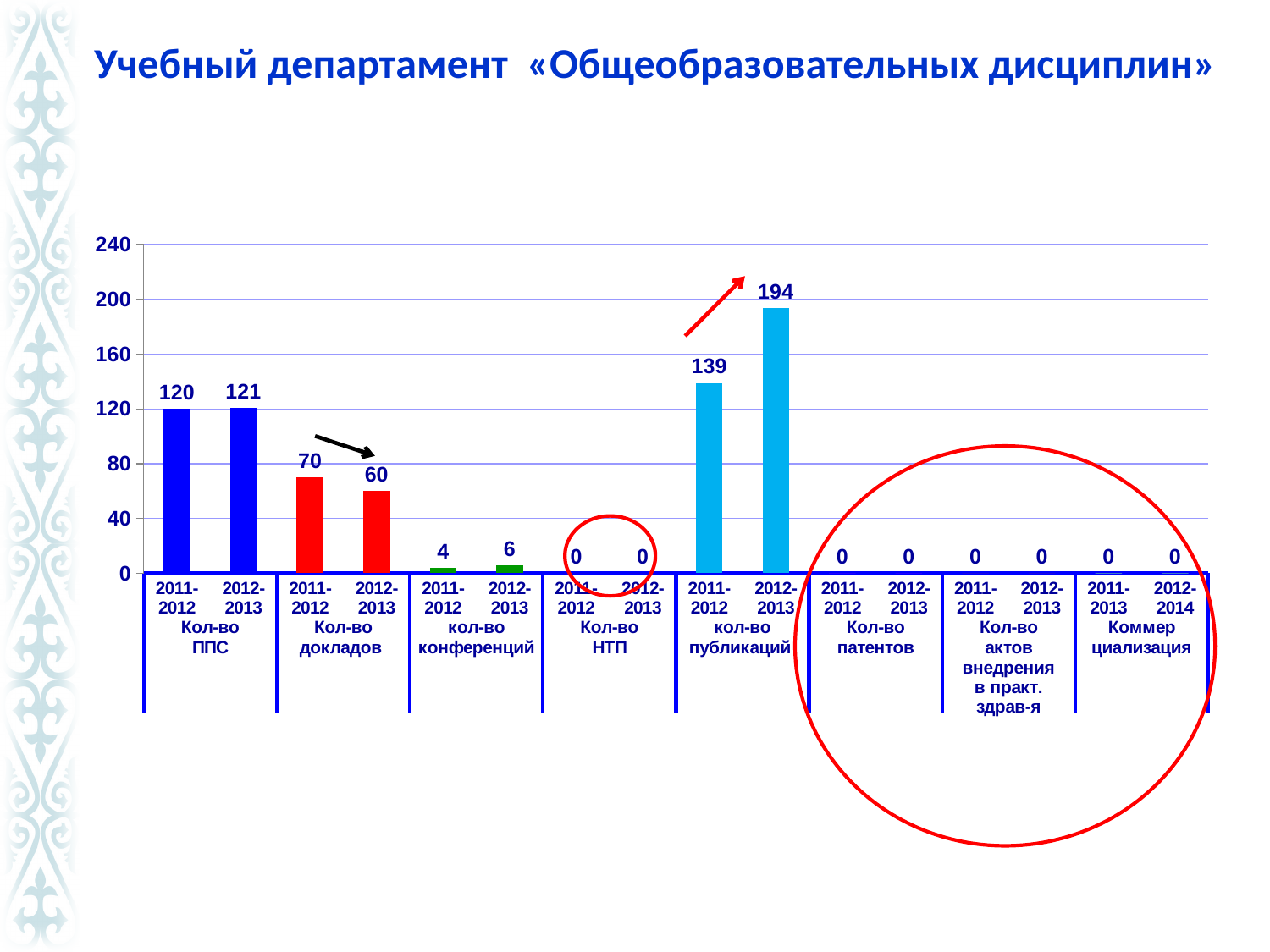
By how much did "кол-во публикаций" increase from 2011-2012 to 2012-2013? 55 What is the value for "кол-во конференций" in 2011-2012? 4 What is the difference between "Кол-во докладов" in 2011-2012 and 2012-2013? 10 What is the value for "Кол-во ППС" in 2011-2012? 120 Which bar has the highest value on the chart? кол-во публикаций, 2012-2013 Which is larger: "Кол-во ППС" in 2012-2013 or "кол-во публикаций" in 2011-2012? кол-во публикаций in 2011-2012 What type of chart is shown on the slide? bar chart What is the value for "кол-во публикаций" in 2012-2013? 194 What is the value for "Кол-во патентов" in 2012-2013? 0 How many indicator groups are shown along the x axis? 8 What is the value for "Кол-во докладов" in 2012-2013? 60 Did "Кол-во докладов" rise or fall from 2011-2012 to 2012-2013? fall